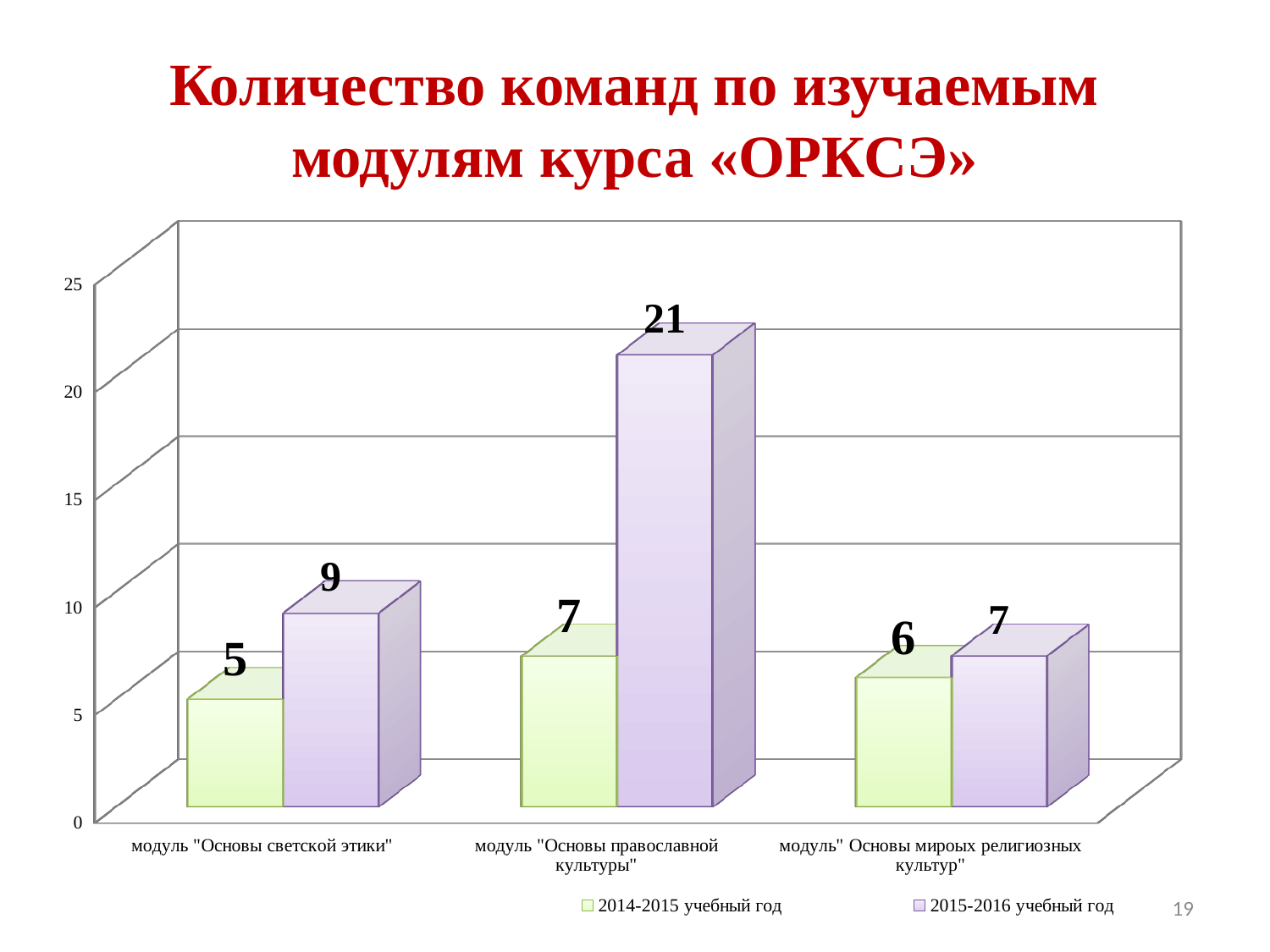
What is the title of the chart? Количество команд по изучаемым модулям курса «ОРКСЭ» What is the value for модуль "Основы светской этики" in the 2014-2015 учебный год series? 5 How many modules (categories) are shown on the x axis? 3 Which module has the lowest value in the 2014-2015 учебный год series? модуль "Основы светской этики" Is the 2015-2016 value for модуль "Основы православной культуры" greater or less than 20? greater Which module has the highest value in the 2015-2016 учебный год series? модуль "Основы православной культуры" Which is larger for модуль "Основы светской этики": the 2014-2015 value or the 2015-2016 value? 2015-2016 учебный год What kind of chart is shown on the slide? bar chart How many series does the legend list? 2 What is the value for модуль "Основы православной культуры" in the 2015-2016 учебный год series? 21 What is the difference between the 2015-2016 and 2014-2015 values for модуль "Основы православной культуры"? 14 What is the value for модуль "Основы мировых религиозных культур" in the 2015-2016 учебный год series? 7